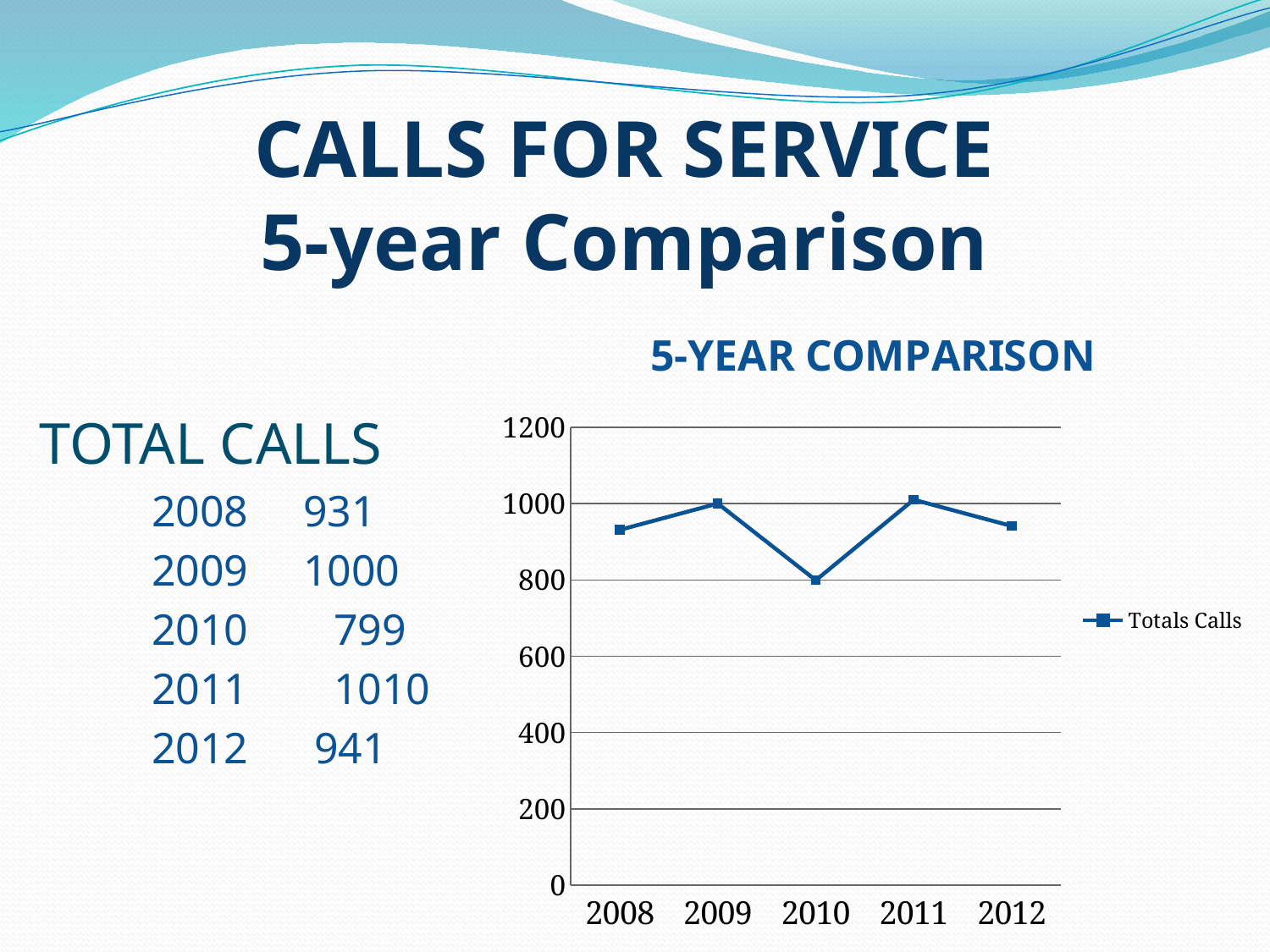
What is the total calls value for 2011? 1010 What is the title of the chart? 5-YEAR COMPARISON Do total calls rise or fall from 2011 to 2012? fall What is the difference in total calls between 2011 and 2010? 211 How many years are plotted on the x axis of the chart? 5 Which year has the highest total calls? 2011 What is the total calls value for 2010? 799 Is the value for 2010 greater or less than 800? less How many series does the chart legend list? 1 What is the name of the series in the chart legend? Totals Calls Which year has the lowest total calls? 2010 What type of chart is shown on the slide? line chart